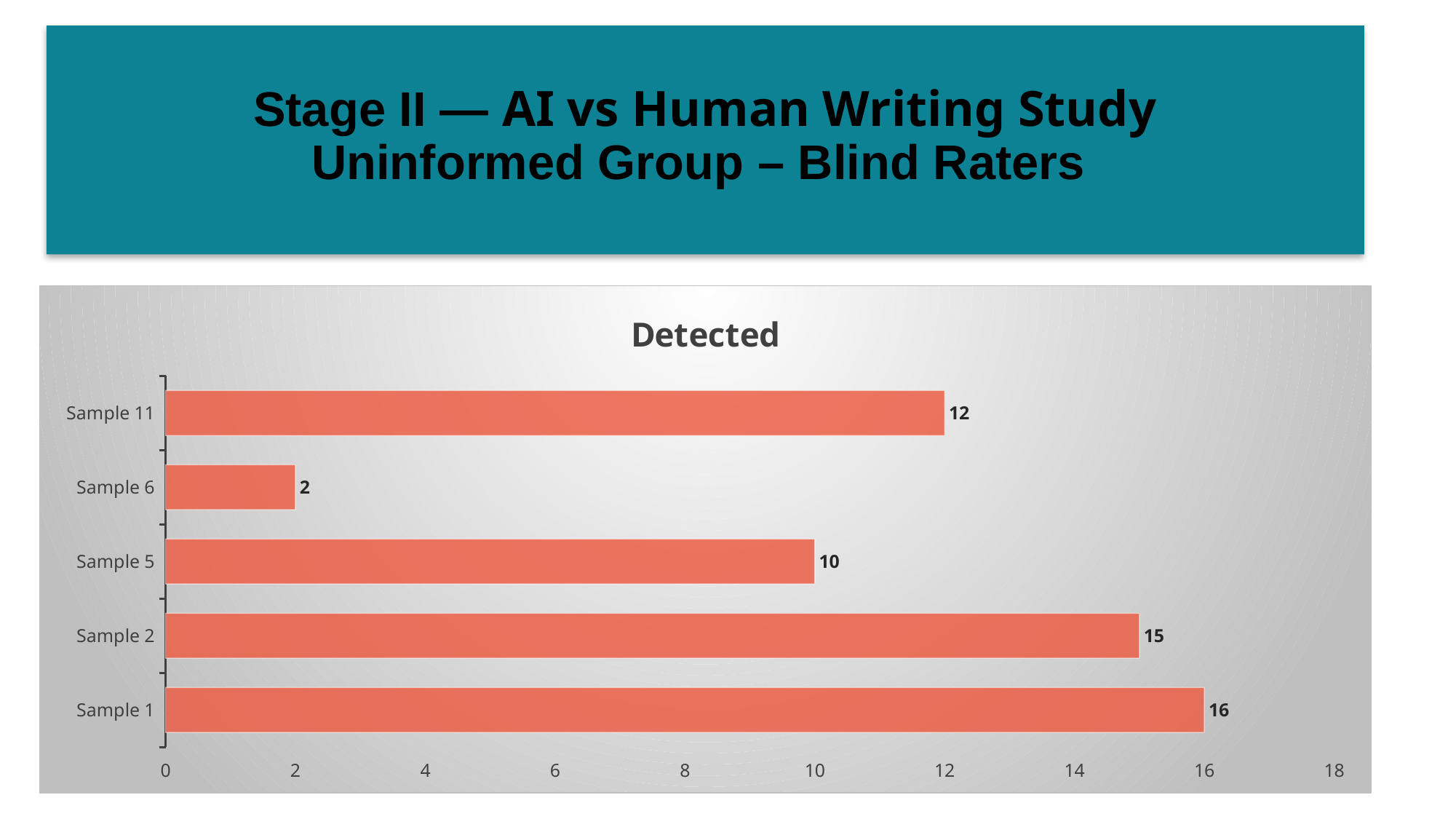
Which sample has the lowest Detected value? Sample 6 How many samples are shown in the chart? 5 What is the difference between the Detected values for Sample 1 and Sample 2? 1 What is the difference between the Detected values for Sample 11 and Sample 6? 10 Is the Detected value for Sample 2 greater or less than 14? greater What is the Detected value for Sample 6? 2 Which sample has the highest Detected value? Sample 1 What is the Detected value for Sample 5? 10 What is the Detected value for Sample 11? 12 Which has a larger Detected value, Sample 5 or Sample 11? Sample 11 What kind of chart is shown on the slide? Bar chart What is the title of the chart? Detected